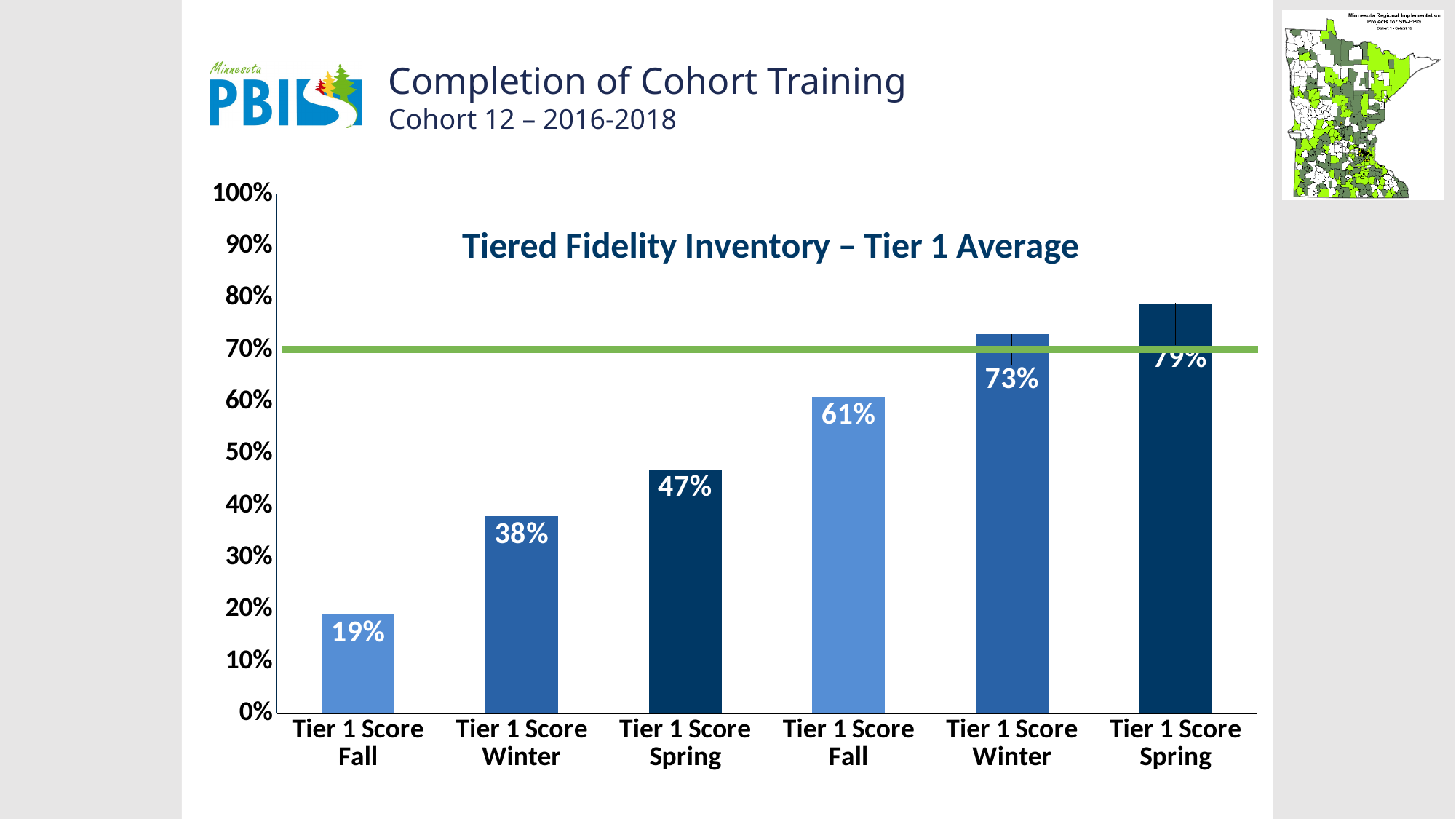
What is the title of the chart? Tiered Fidelity Inventory – Tier 1 Average At what value is the horizontal green line drawn on the chart? 70% What is the difference between the rightmost Tier 1 Score Spring bar and the leftmost Tier 1 Score Fall bar? 60% What is the value of the first Tier 1 Score Spring bar (third bar from the left)? 47% What is the value of the second Tier 1 Score Fall bar (fourth bar from the left)? 61% What type of chart is shown on the slide? bar chart What is the value of the first Tier 1 Score Winter bar (second bar from the left)? 38% Which bar has the lowest value? Tier 1 Score Fall (leftmost bar) How many bars are plotted in the chart? 6 Do the values rise or fall from left to right across the bars? rise What is the value of the first (leftmost) Tier 1 Score Fall bar? 19% What is the value of the rightmost Tier 1 Score Spring bar? 79%